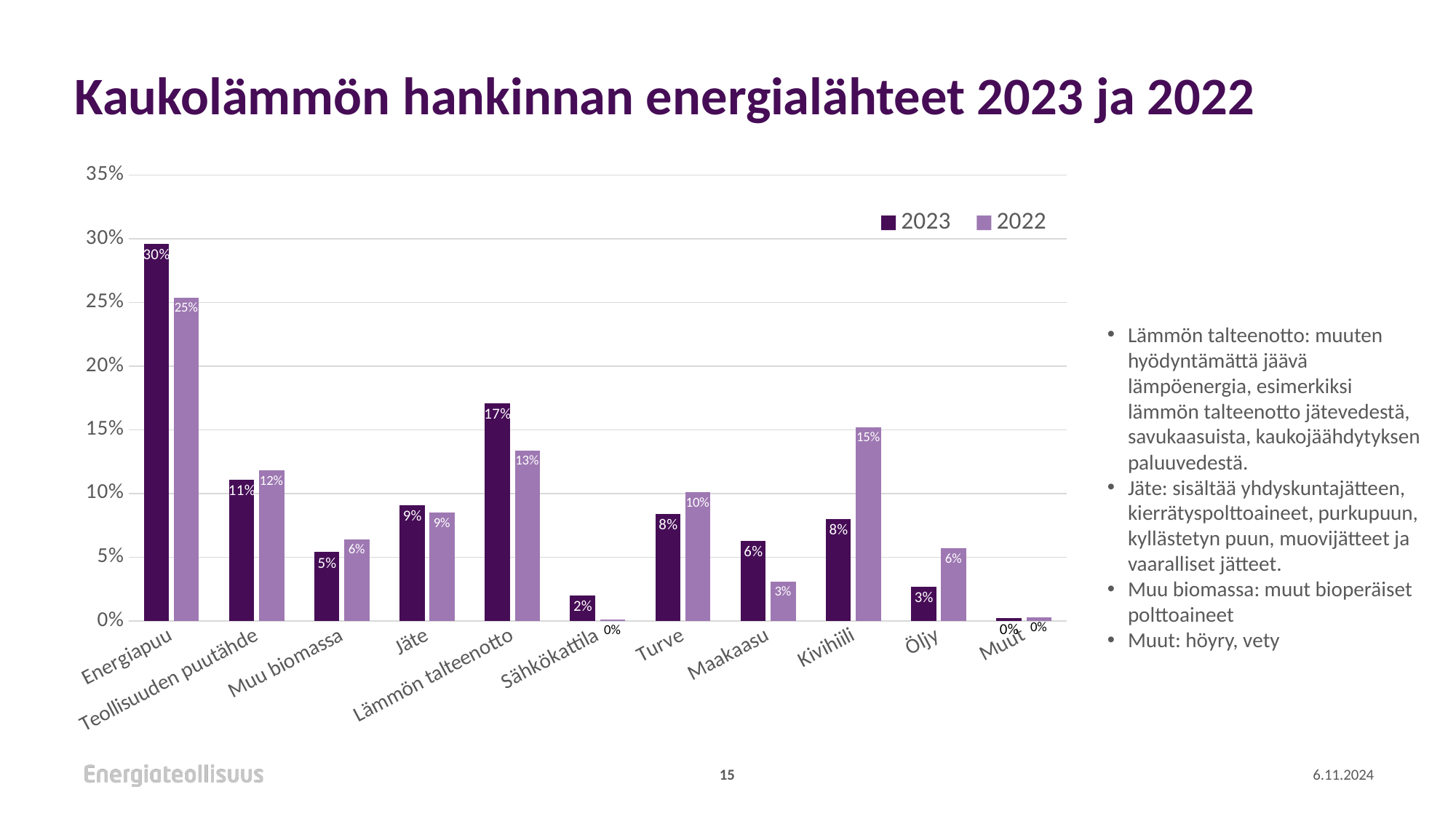
What is the title of the chart on the slide? Kaukolämmön hankinnan energialähteet 2023 ja 2022 How many categories are shown on the x axis? 11 What is the 2023 value for Energiapuu? 30% How many series does the legend list? 2 Which is larger for Turve: the 2023 value or the 2022 value? 2022 What is the 2022 value for Kivihiili? 15% What is the 2023 value for Lämmön talteenotto? 17% Which category has the highest 2023 value? Energiapuu What kind of chart is shown on the slide? Bar chart Is the 2022 value for Energiapuu greater or less than 20%? greater What is the difference between the 2023 and 2022 values for Kivihiili? 7%